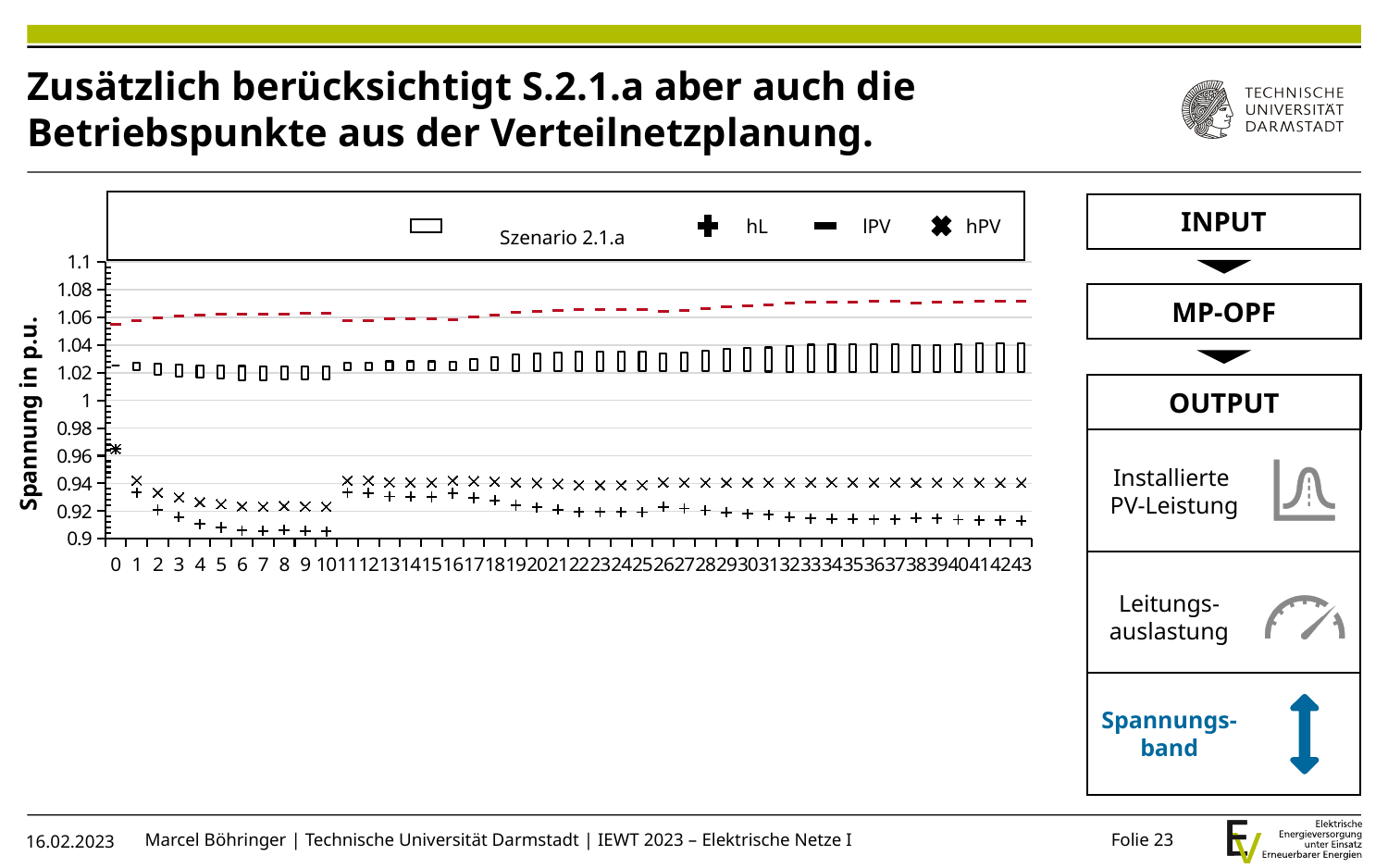
At x = 43, which series has the larger value, lPV or hPV? lPV What is the title of the y axis of the chart? Spannung in p.u. How many series does the chart legend list? 4 Is the value of the hPV series at x = 43 greater or less than 0.96? less Does the lPV series rise or fall from x = 11 to x = 43? rise Is the value of the hL series at x = 10 greater or less than 0.92? less Is the value of the lPV series at x = 43 greater or less than 1.06? greater What are the names of the series listed in the chart legend? Szenario 2.1.a, hL, lPV, hPV How many points are labelled along the x axis of the chart? 44 Does the hL series rise or fall from x = 11 to x = 43? fall What kind of chart is shown on the slide? combination bar and line chart